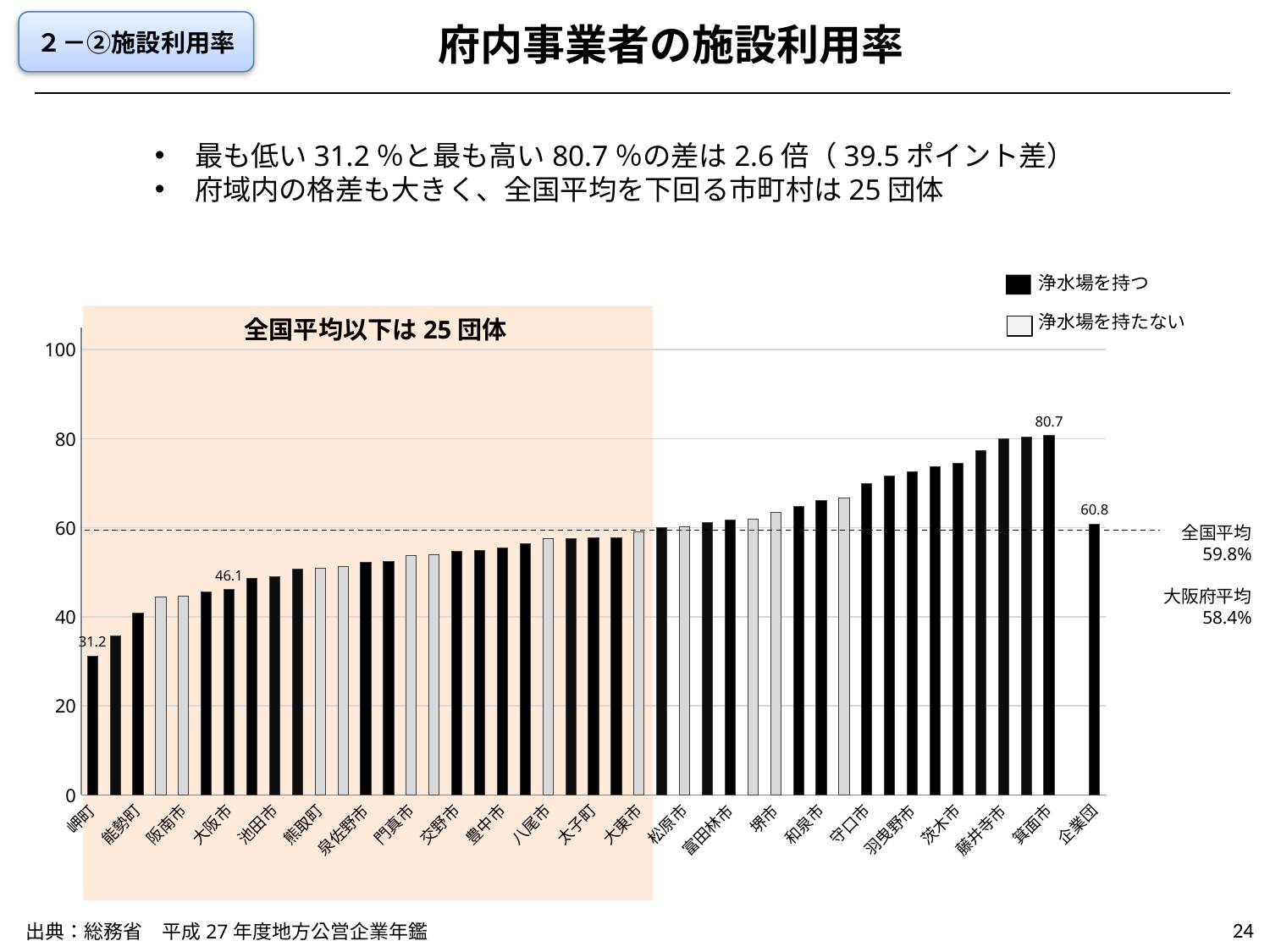
What is the facility utilization rate shown for 大阪市? 46.1 Which municipality has the highest facility utilization rate in the chart? 箕面市 What is the facility utilization rate shown for 企業団? 60.8 Which municipality has the lowest facility utilization rate in the chart? 岬町 What is the national average (全国平均) shown by the dashed line? 59.8% Which has a higher facility utilization rate, 大阪市 or 企業団? 企業団 What is the difference between the highest value (箕面市) and the lowest value (岬町)? 49.5 What is the facility utilization rate shown for 箕面市? 80.7 Is the value for 守口市 greater or less than 60? greater What is the facility utilization rate shown for 岬町? 31.2 What is the difference between the values for 箕面市 and 企業団? 19.9 How many series does the legend list? 2